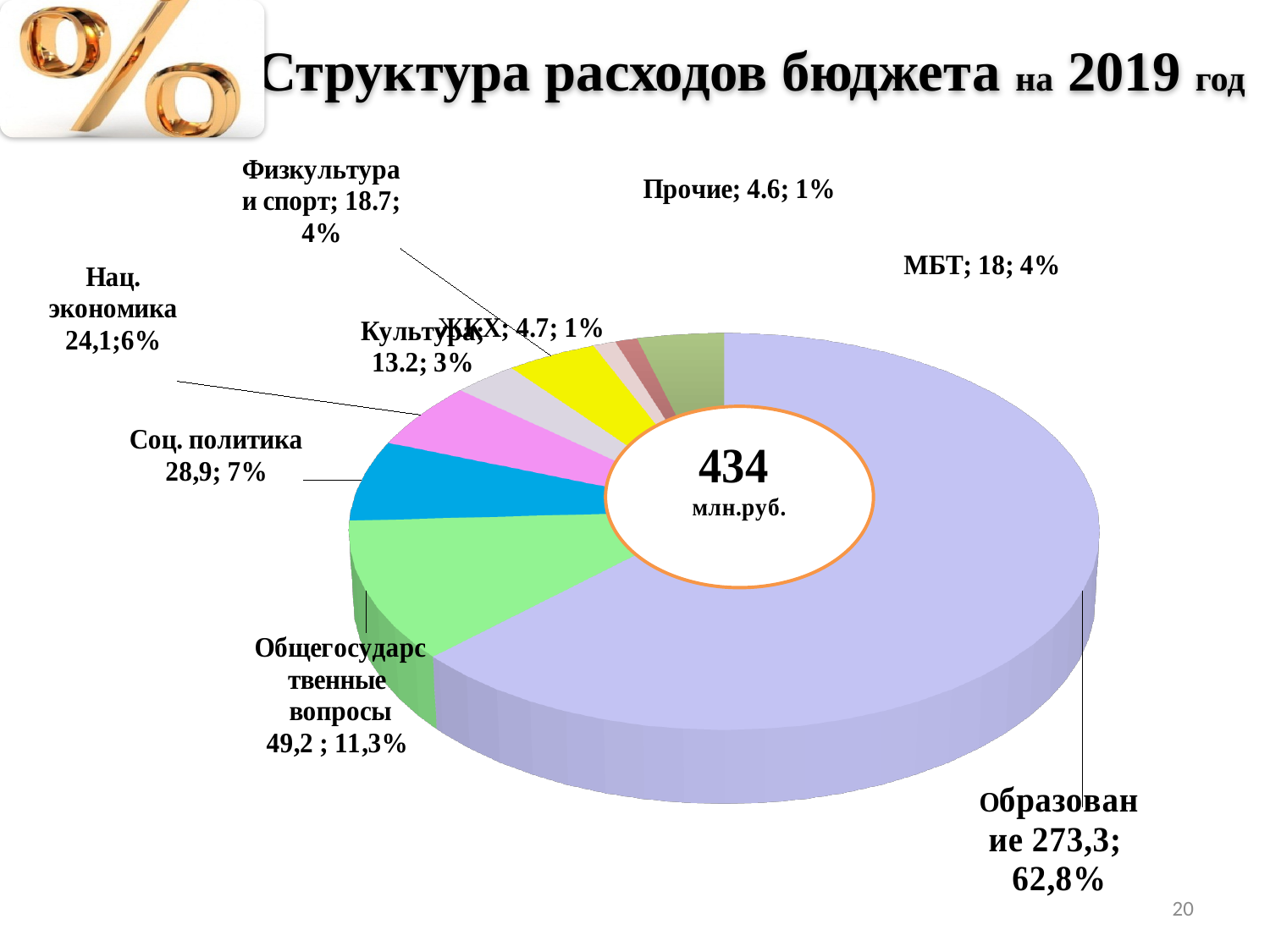
What is the difference between the values for Образование and Общегосударственные вопросы? 224,1 What is the value for Нац. экономика? 24,1 What is the value for Общегосударственные вопросы? 49,2 What is the value for Образование? 273,3 What kind of chart is shown on the slide? pie chart What share of the pie does Соц. политика take? 7% How many categories are shown in the pie chart? 9 Which is larger, Соц. политика or Нац. экономика? Соц. политика Which category has the largest slice of the pie? Образование What is the value for МБТ? 18 What total is shown in the centre of the chart? 434 млн.руб. What share of the pie does Образование take? 62,8%